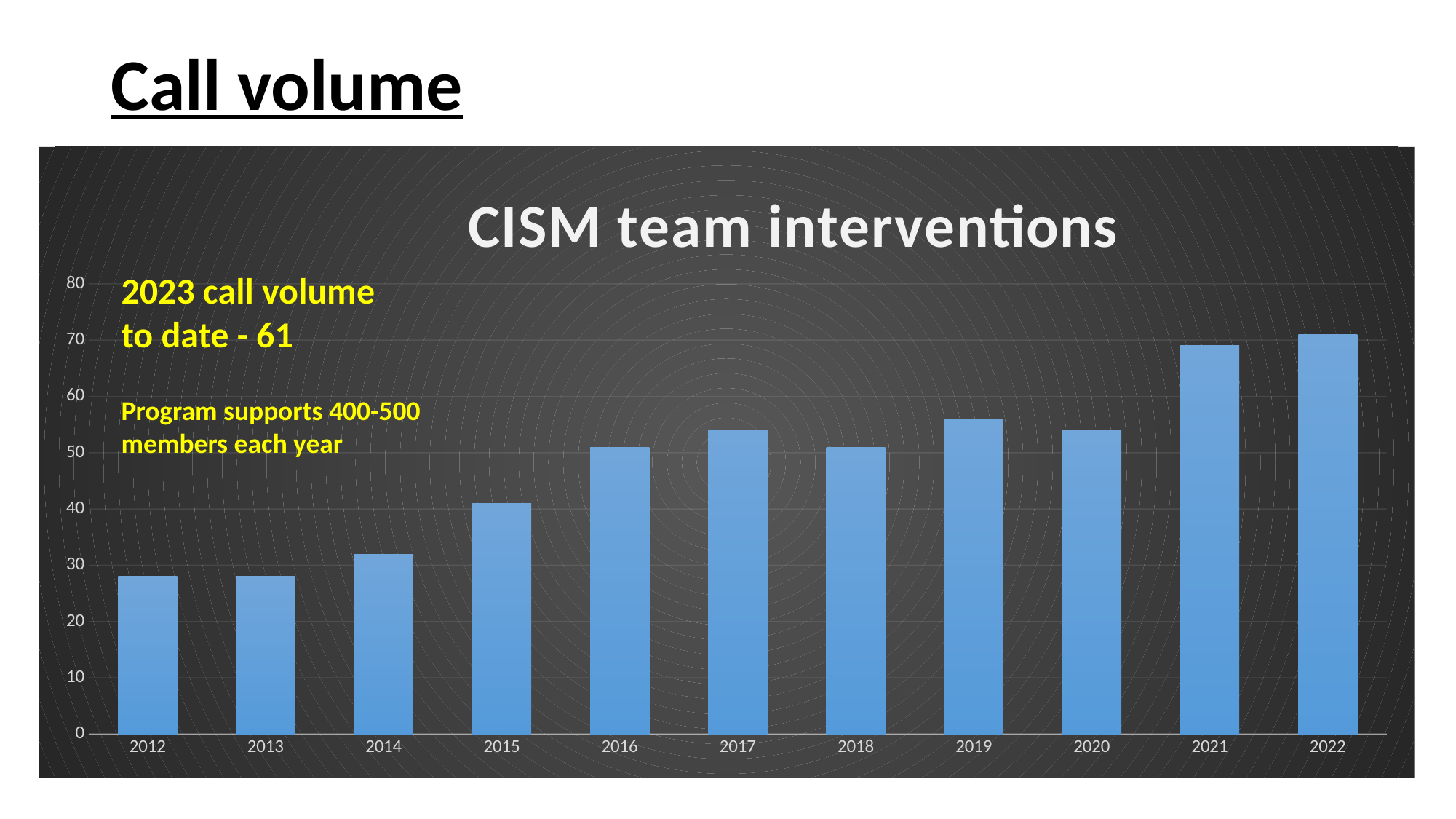
Is the value for 2015 greater or less than 50? less What kind of chart is shown on the slide? bar chart Is the value for 2021 greater or less than 60? greater Which year has the highest number of CISM team interventions? 2022 Do the values generally rise or fall from 2012 to 2022? rise According to the text on the chart, what is the 2023 call volume to date? 61 Is the value for 2019 greater or less than 50? greater Which is larger, the value for 2015 or the value for 2016? 2016 Which is larger, the value for 2014 or the value for 2017? 2017 What is the title of the chart? CISM team interventions How many years are shown on the x axis of the chart? 11